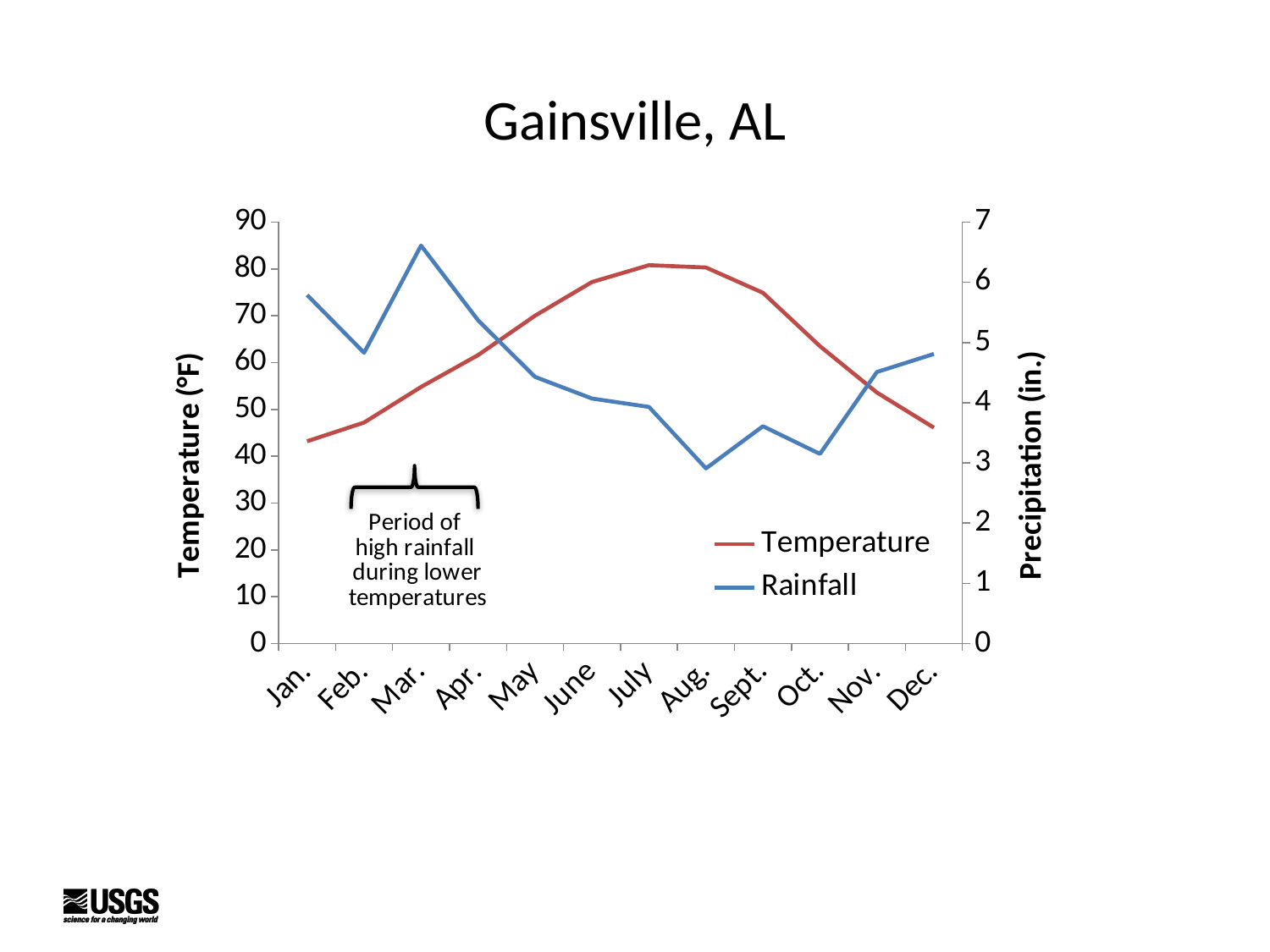
In which month is Rainfall highest? Mar. How many months are plotted along the x axis? 12 In which month is Rainfall lowest? Aug. Is the Rainfall value for Aug. greater or less than 4? less Does the Rainfall line rise or fall from Mar. to Aug.? fall Is the Rainfall value for Mar. greater or less than 6? greater Is the Temperature value for July greater or less than 70? greater Does the Temperature line rise or fall from Jan. to July? rise How many series does the legend list? 2 What is the title of the chart? Gainsville, AL What kind of chart is shown on the slide? Line chart